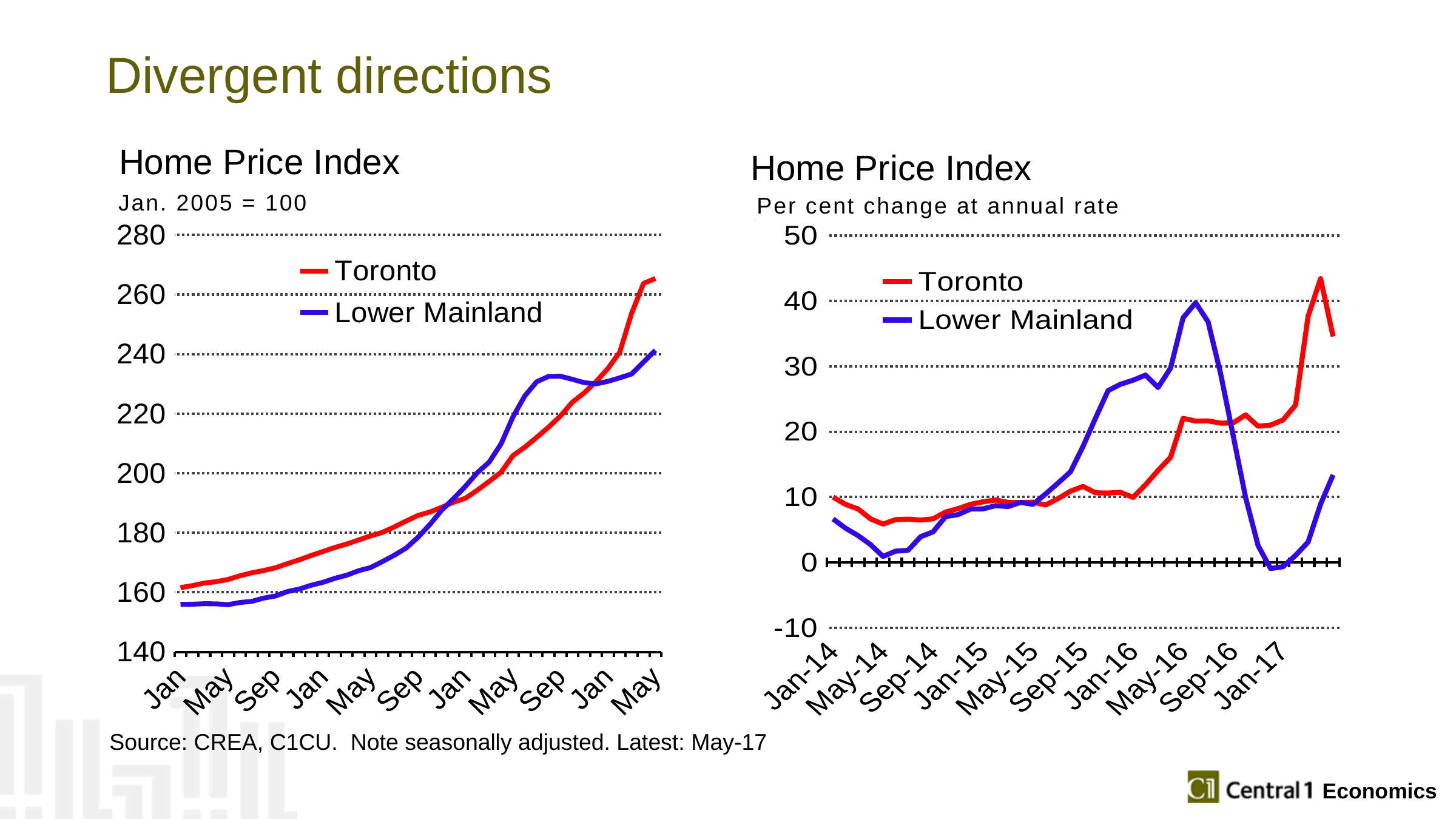
In the left chart (Jan. 2005 = 100), is the value for Toronto at the final May greater or less than 260? greater How many series does the legend of the right chart (Per cent change at annual rate) list? 2 In the right chart (Per cent change at annual rate), is the peak value for Lower Mainland greater or less than 30? greater What kind of chart is the left chart, Home Price Index (Jan. 2005 = 100)? line chart What is the subtitle of the right chart? Per cent change at annual rate In the right chart (Per cent change at annual rate), which series is higher at Sep-16, Toronto or Lower Mainland? Toronto In the left chart (Jan. 2005 = 100), which series is higher at the final May, Toronto or Lower Mainland? Toronto In the left chart (Jan. 2005 = 100), which series is shown in red? Toronto In the left chart (Jan. 2005 = 100), is the value for Lower Mainland at the final May greater or less than 220? greater In the left chart (Jan. 2005 = 100), does the Toronto line generally rise or fall from left to right? rise